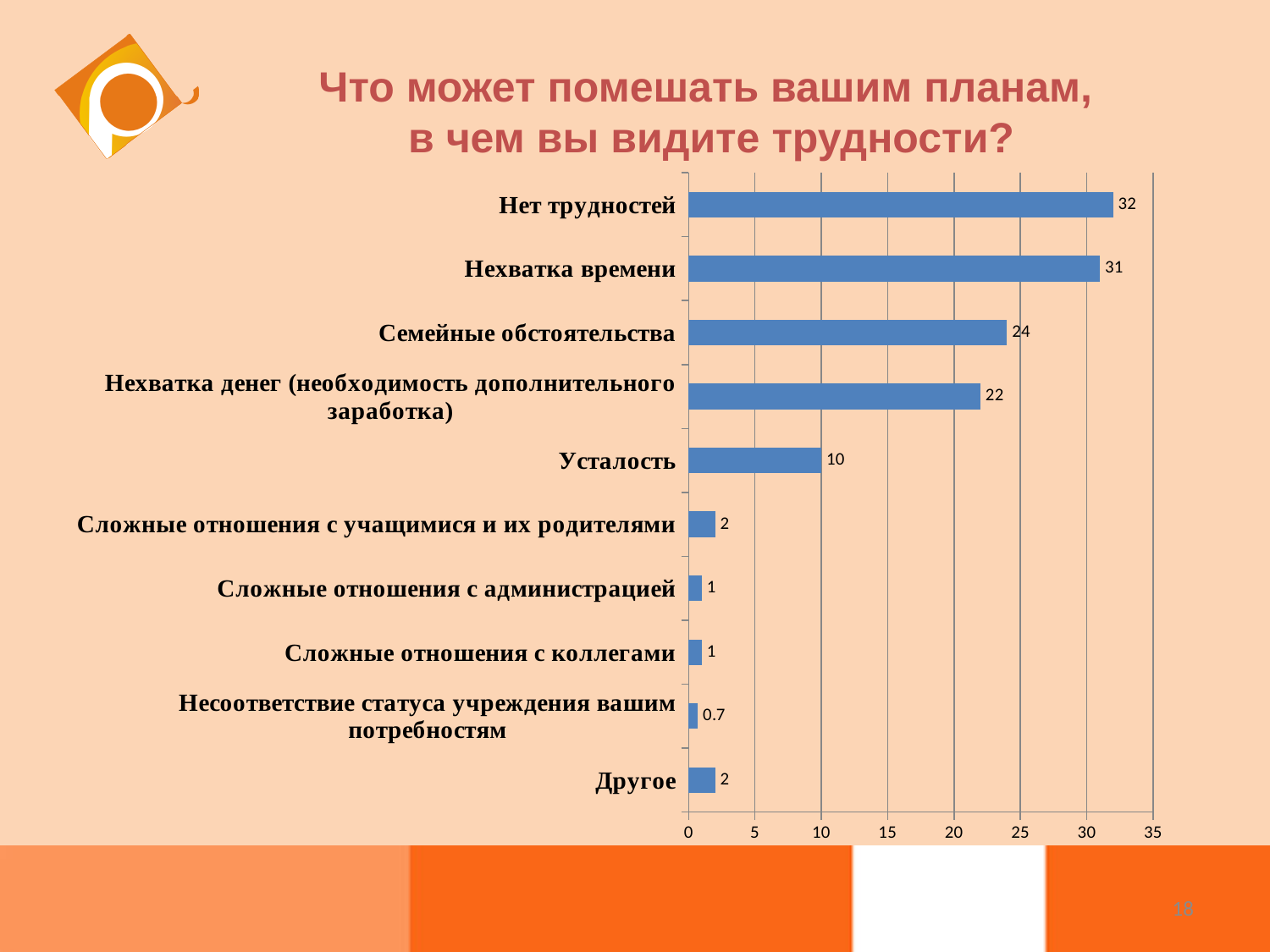
What is the value for "Несоответствие статуса учреждения вашим потребностям"? 0.7 Is the value for "Нехватка времени" greater or less than 30? greater What is the value for "Усталость"? 10 Which category has the lowest value? Несоответствие статуса учреждения вашим потребностям What is the title of the slide? Что может помешать вашим планам, в чем вы видите трудности? How many categories are shown in the chart? 10 What kind of chart is shown on the slide? bar chart Which is larger: the value for "Семейные обстоятельства" or the value for "Нехватка денег (необходимость дополнительного заработка)"? Семейные обстоятельства What is the difference between the values for "Нет трудностей" and "Семейные обстоятельства"? 8 What is the value for "Нехватка денег (необходимость дополнительного заработка)"? 22 Which category has the highest value? Нет трудностей What is the value for "Нет трудностей"? 32